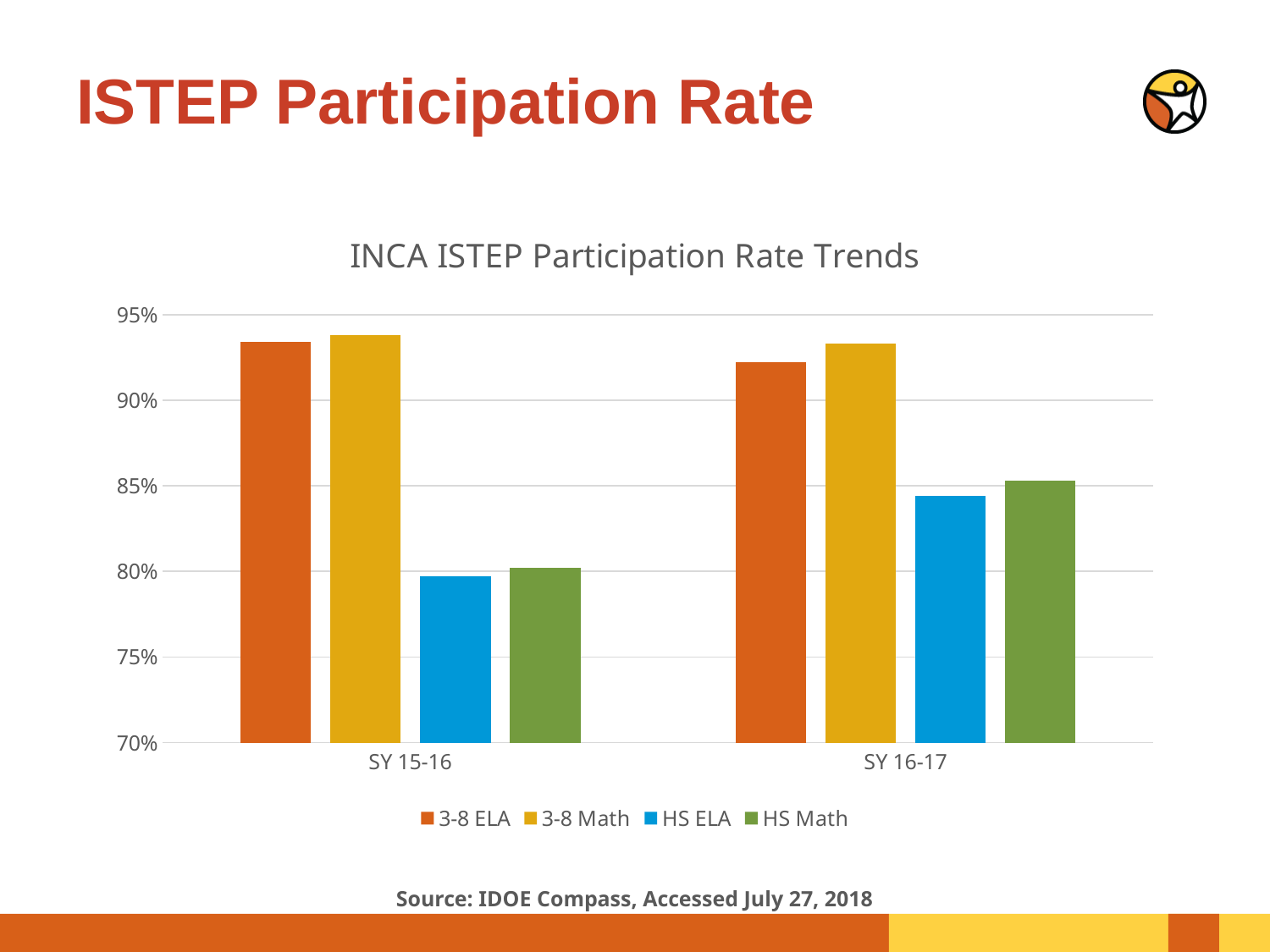
Is the value for HS Math in SY 16-17 greater or less than 80%? greater Which is larger, HS ELA in SY 15-16 or HS ELA in SY 16-17? HS ELA in SY 16-17 What type of chart is shown on the slide? bar chart Which series has the highest value in SY 16-17? 3-8 Math What is the title of the chart? INCA ISTEP Participation Rate Trends Is the value for HS ELA in SY 15-16 greater or less than 85%? less Is the value for 3-8 ELA in SY 15-16 greater or less than 90%? greater How many series does the legend list? 4 Which is larger, 3-8 ELA in SY 15-16 or 3-8 ELA in SY 16-17? 3-8 ELA in SY 15-16 Does the HS ELA participation rate rise or fall from SY 15-16 to SY 16-17? rise How many school years are shown on the x axis? 2